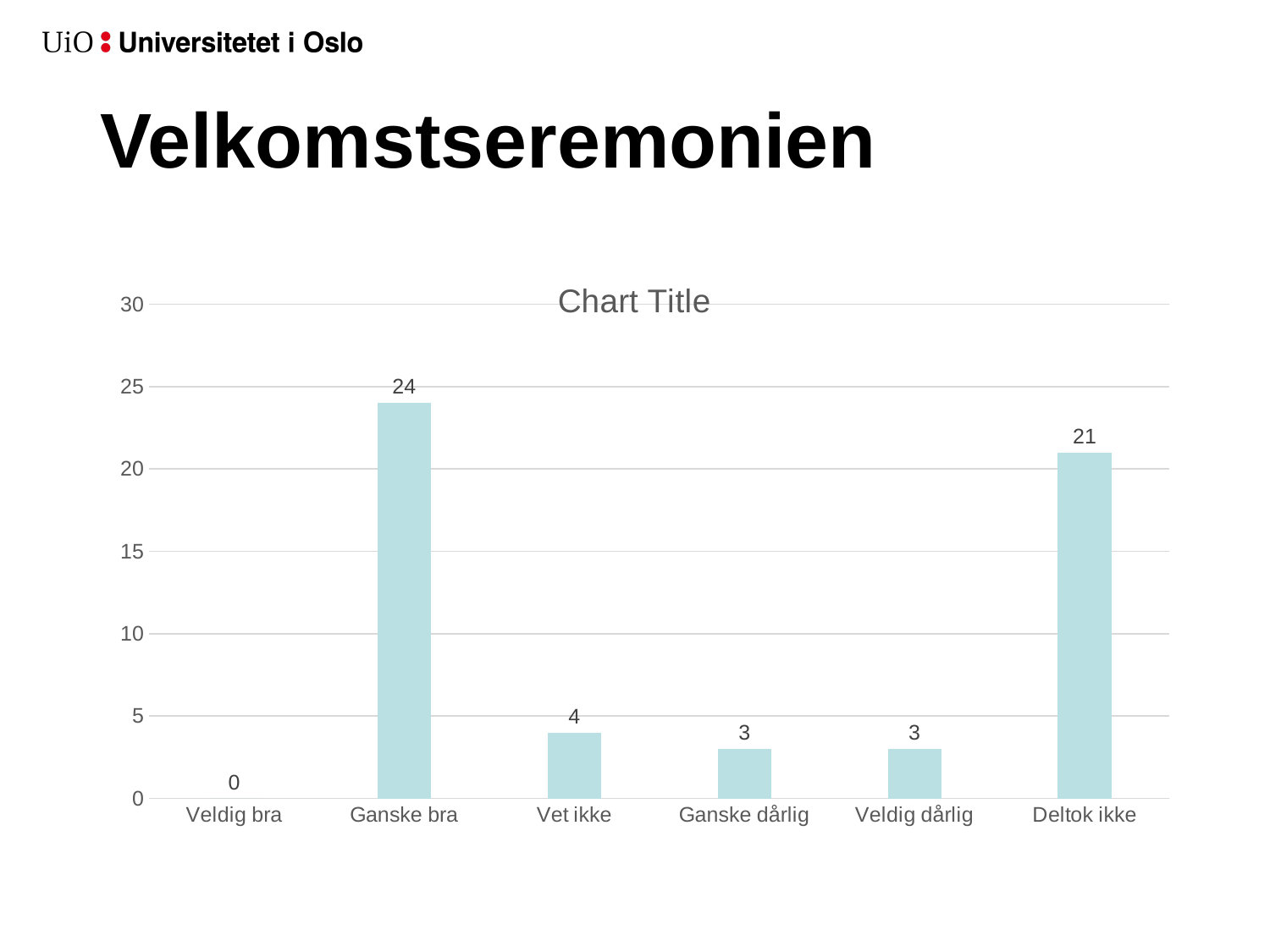
What kind of chart is shown on the slide? bar chart What is the value for Deltok ikke? 21 Which category has the lowest value? Veldig bra What is the difference between the values for Ganske bra and Deltok ikke? 3 What is the value for Ganske bra? 24 Which is larger, the value for Vet ikke or the value for Ganske dårlig? Vet ikke What is the title shown above the chart? Chart Title Is the value for Deltok ikke greater or less than 20? greater Which category has the highest value? Ganske bra What is the value for Veldig bra? 0 What is the value for Vet ikke? 4 How many categories are shown on the x axis? 6